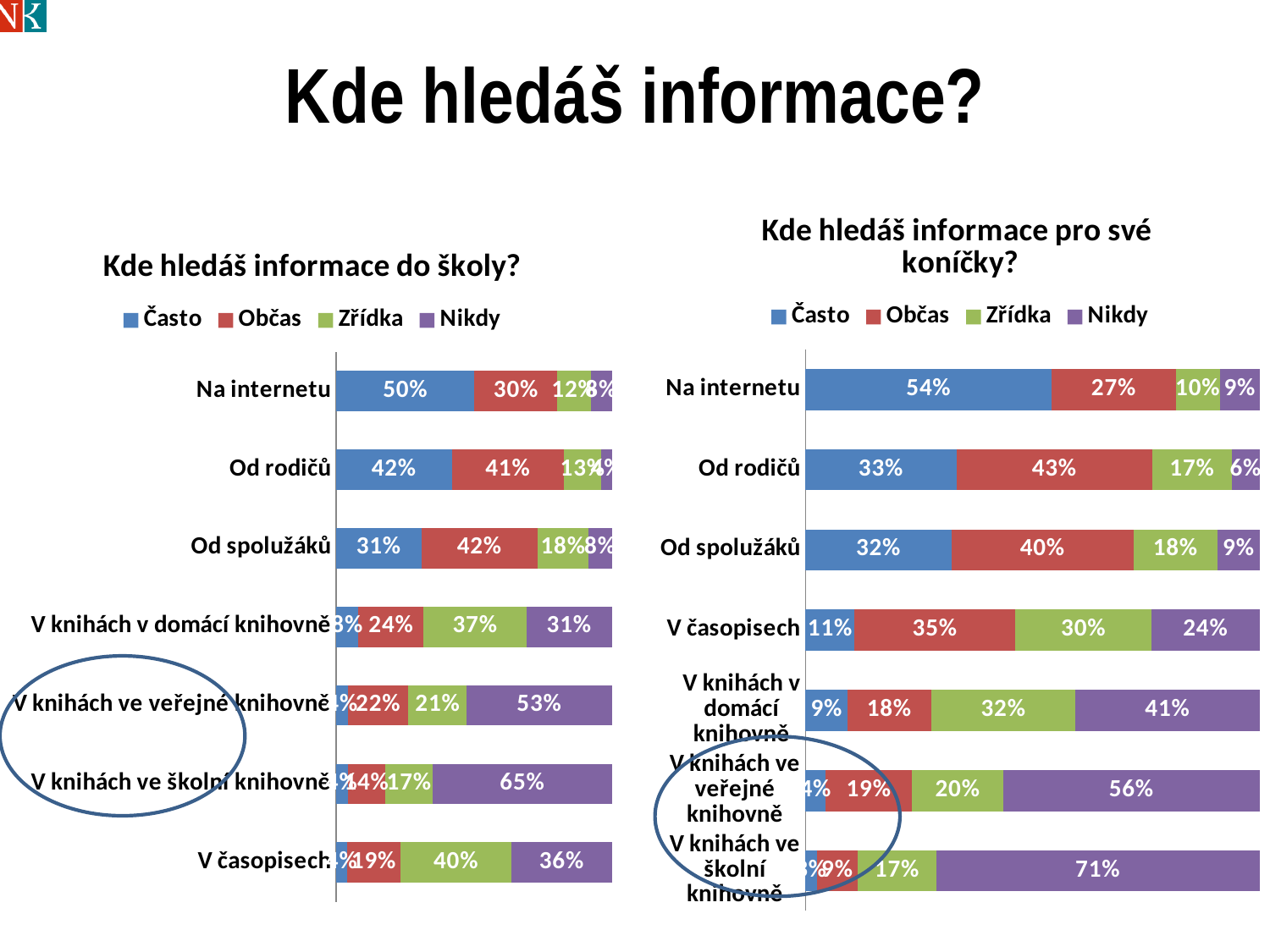
In the chart 'Kde hledáš informace do školy?', which category has the highest Často value? Na internetu In the chart 'Kde hledáš informace do školy?', what is the Nikdy value for V knihách ve školní knihovně? 65% In the chart 'Kde hledáš informace do školy?', what is the Často value for Na internetu? 50% How many series does the legend of the chart 'Kde hledáš informace do školy?' list? 4 In the chart 'Kde hledáš informace pro své koníčky?', which category has the highest Nikdy value? V knihách ve školní knihovně In the chart 'Kde hledáš informace do školy?', what is the Zřídka value for V časopisech? 40% In the chart 'Kde hledáš informace pro své koníčky?', is the Často value for Na internetu or for Od rodičů larger? Na internetu In the chart 'Kde hledáš informace pro své koníčky?', what is the Občas value for Od rodičů? 43% In the chart 'Kde hledáš informace pro své koníčky?', what is the Často value for Na internetu? 54% What kind of chart is 'Kde hledáš informace pro své koníčky?'? Stacked bar chart In the chart 'Kde hledáš informace pro své koníčky?', what is the Nikdy value for V knihách ve školní knihovně? 71% In the chart 'Kde hledáš informace do školy?', what is the difference between the Nikdy values for V knihách ve školní knihovně and V knihách ve veřejné knihovně? 12%